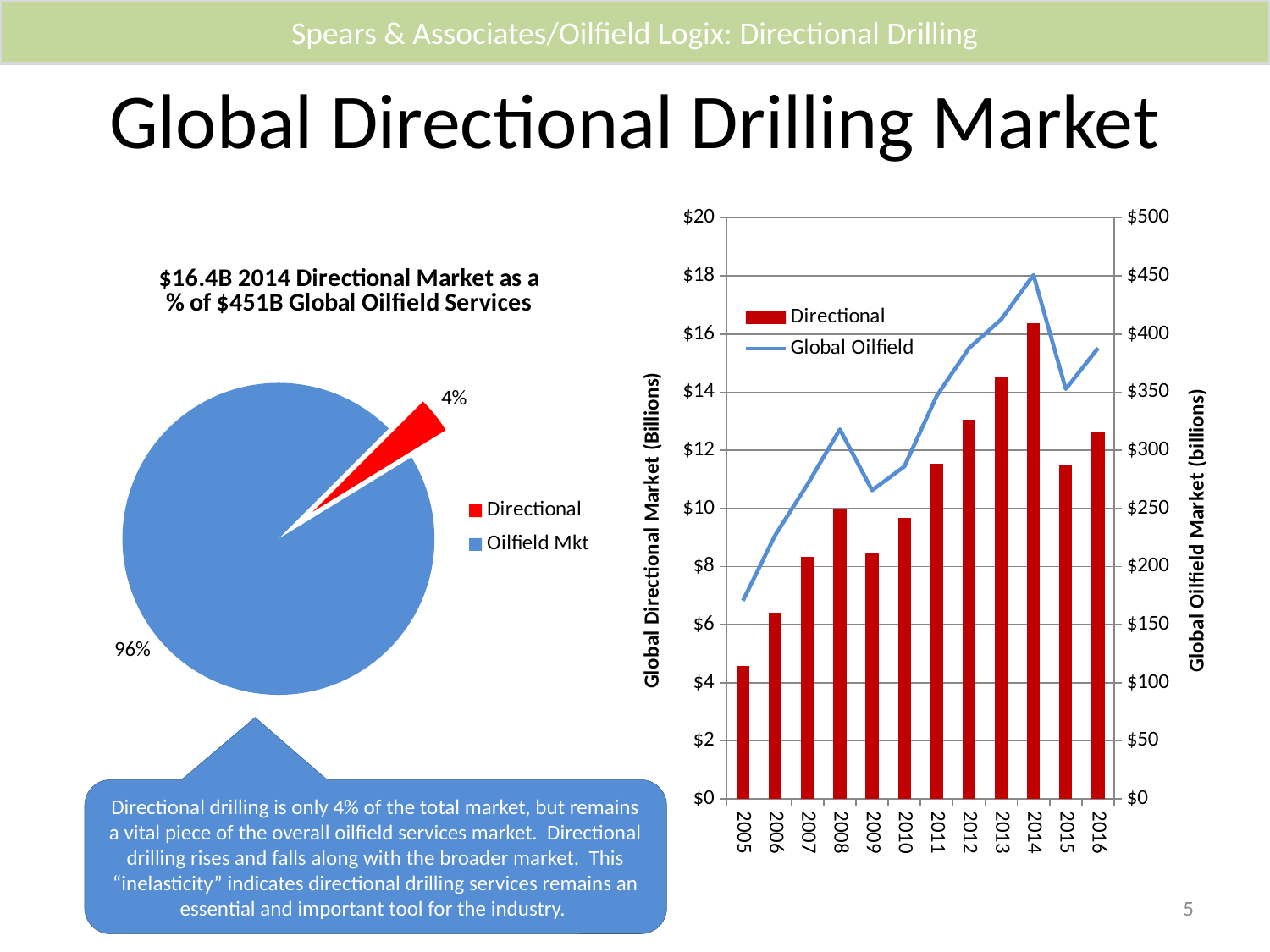
In the chart on the right, is the Directional value for 2005 greater or less than $6? less In the chart on the right, do the Directional bars rise or fall from 2005 to 2008? Rise In the chart on the right, which year has the highest Directional bar? 2014 In the pie chart on the left, what share of the market is Oilfield Mkt? 96% How many slices does the pie chart on the left have? 2 In the chart on the right, how many series does the legend list? 2 In the chart on the right, which year has the larger Directional bar, 2013 or 2015? 2013 What kind of chart is the chart on the left of the slide? Pie chart In the chart on the right, is the Directional value for 2014 greater or less than $14? greater In the chart on the right, how many years are shown on the x axis? 12 In the pie chart on the left, what share of the market is Directional? 4% In the chart on the right, which year has the lowest Directional bar? 2005